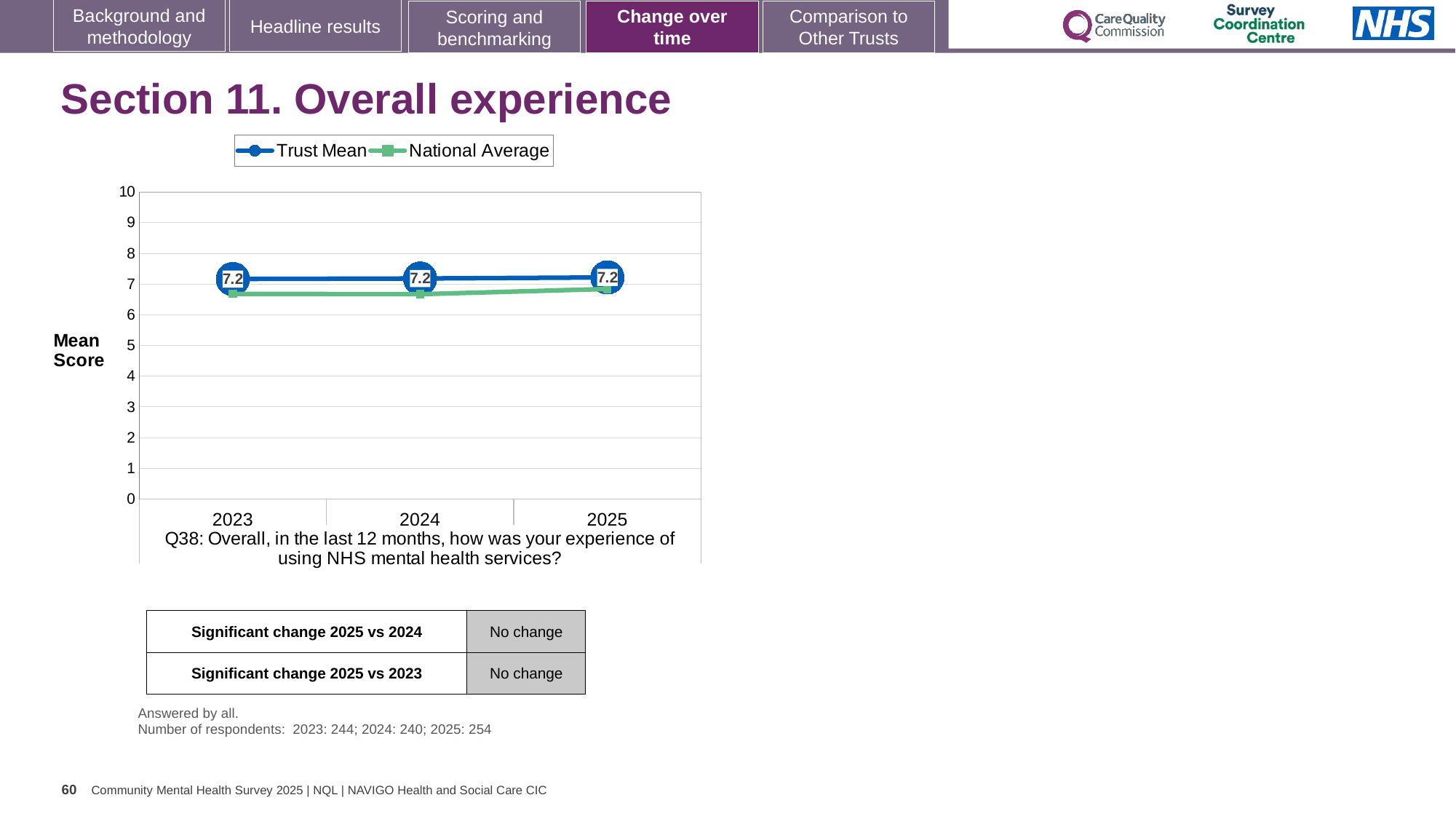
What are the two series named in the legend? Trust Mean and National Average What is the Trust Mean value for 2023? 7.2 Is the National Average value for 2023 greater or less than 7? less What kind of chart is shown on the slide? Line chart What is the Trust Mean value for 2024? 7.2 How many series does the legend list? 2 How many years are plotted on the x axis? 3 Is the National Average value for 2025 greater or less than 6? greater In 2023, which is larger: the Trust Mean or the National Average? Trust Mean What is the label on the y axis of the chart? Mean Score What is the Trust Mean value for 2025? 7.2 Does the Trust Mean rise, fall or stay the same from 2023 to 2025? Stays the same